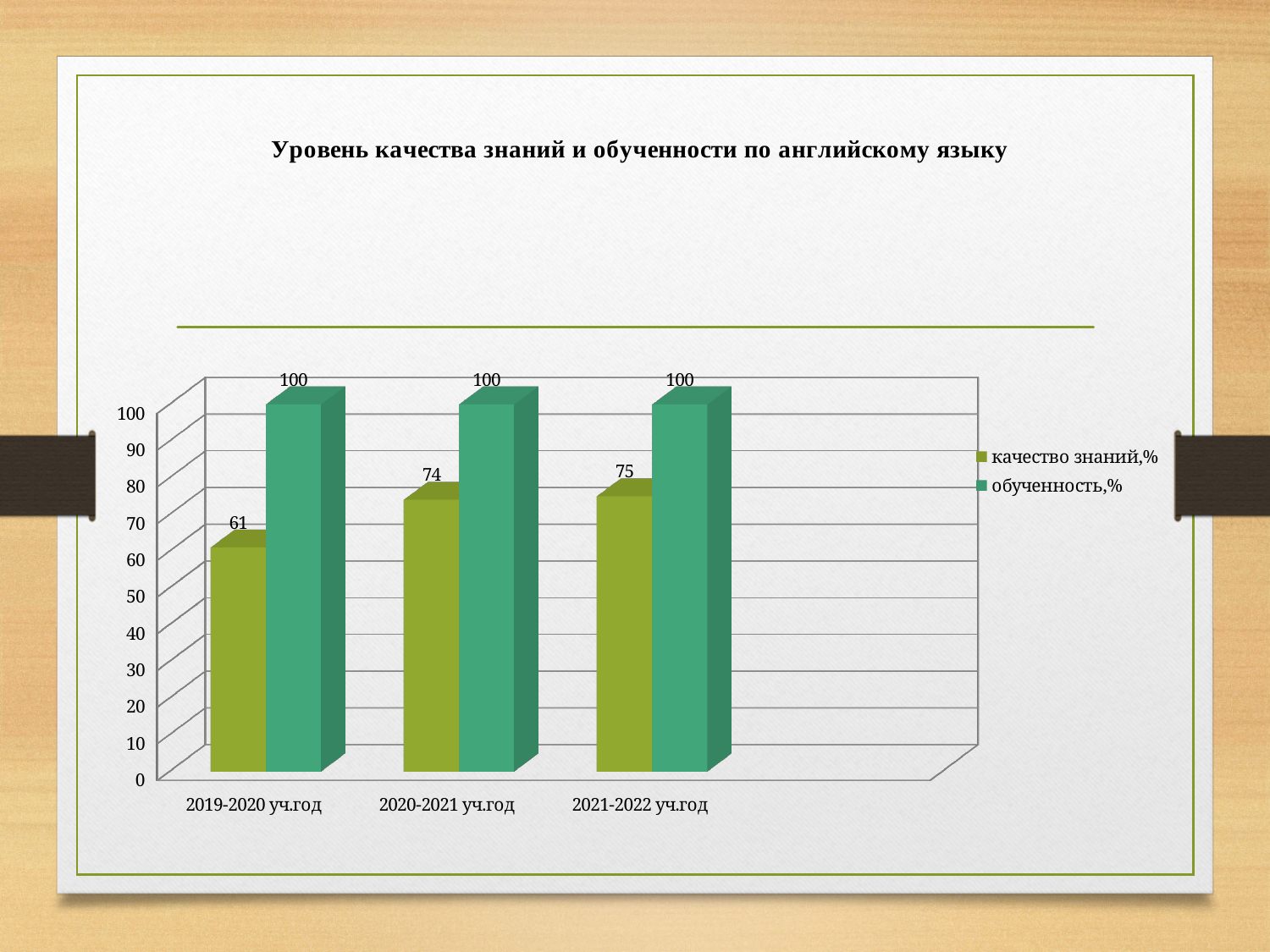
How many years are shown on the x axis? 3 What is the value of качество знаний,% for 2020-2021 уч.год? 74 What is the value of качество знаний,% for 2019-2020 уч.год? 61 What is the title of the chart? Уровень качества знаний и обученности по английскому языку What is the difference between качество знаний,% in 2020-2021 уч.год and 2019-2020 уч.год? 13 How many series does the legend list? 2 What is the value of обученность,% for 2021-2022 уч.год? 100 Which year has the lowest value for качество знаний,%? 2019-2020 уч.год Does качество знаний,% rise or fall from 2019-2020 уч.год to 2021-2022 уч.год? rise What kind of chart is shown on the slide? bar chart Which year has the highest value for качество знаний,%? 2021-2022 уч.год Which is larger: качество знаний,% in 2019-2020 уч.год or обученность,% in 2019-2020 уч.год? обученность,%